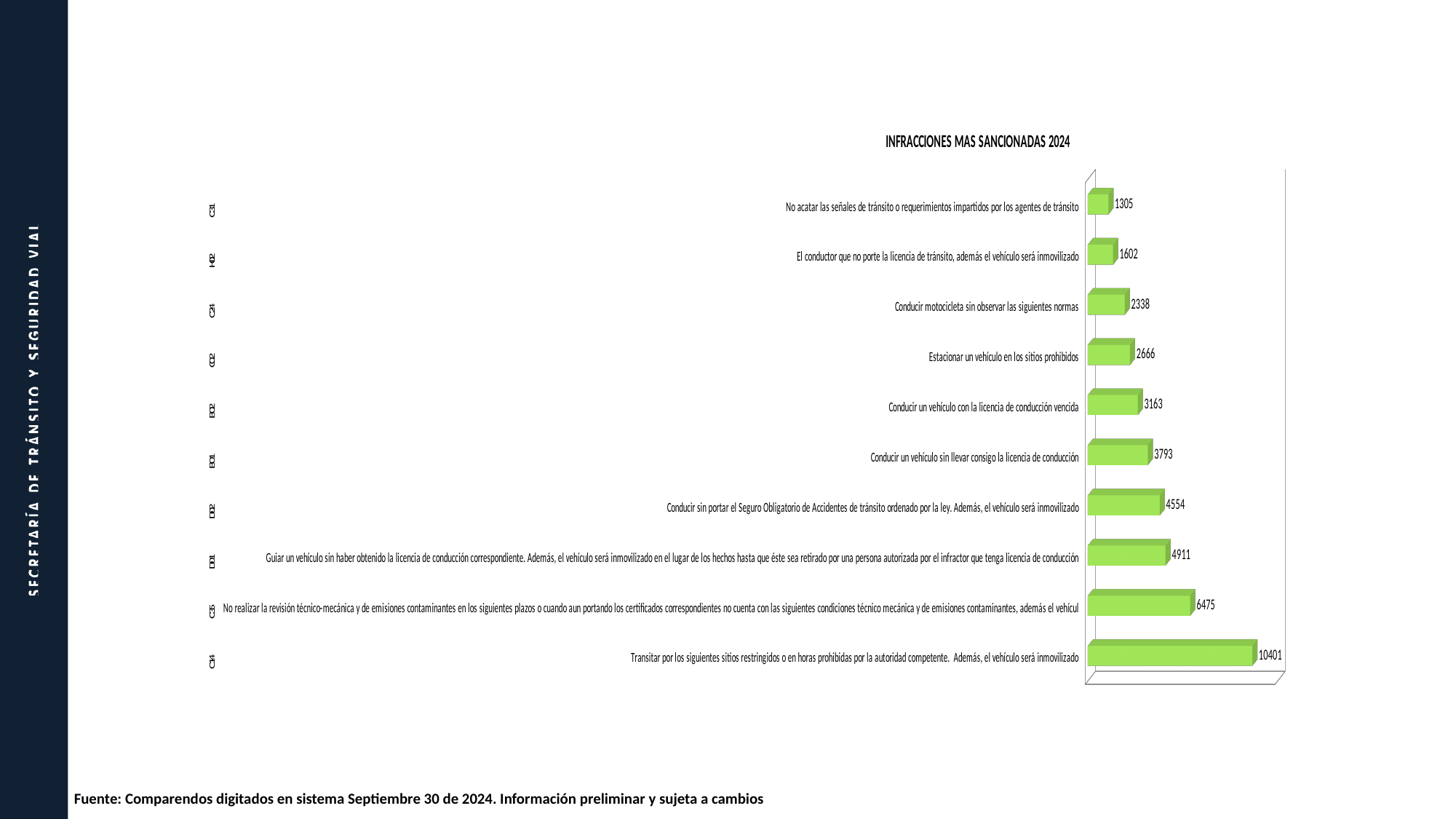
What is the difference between the value for the infraction about transiting restricted sites or prohibited hours (10401) and the value for not performing the technical-mechanical review (6475)? 3926 What is the value for "Conducir motocicleta sin observar las siguientes normas"? 2338 What is the value for "No acatar las señales de tránsito o requerimientos impartidos por los agentes de tránsito"? 1305 What kind of chart is shown on the slide? Bar chart What is the value for "Estacionar un vehículo en los sitios prohibidos"? 2666 What is the value for "Conducir un vehículo sin llevar consigo la licencia de conducción"? 3793 Which infraction has the lowest value in the chart? No acatar las señales de tránsito o requerimientos impartidos por los agentes de tránsito What is the title of the chart? INFRACCIONES MAS SANCIONADAS 2024 How many infraction categories are plotted in the chart? 10 Which is larger: the value for "Conducir un vehículo con la licencia de conducción vencida" or the value for "El conductor que no porte la licencia de tránsito, además el vehículo será inmovilizado"? Conducir un vehículo con la licencia de conducción vencida What is the difference between the value for "Conducir un vehículo sin llevar consigo la licencia de conducción" and the value for "Conducir un vehículo con la licencia de conducción vencida"? 630 Which infraction has the highest value in the chart? Transitar por los siguientes sitios restringidos o en horas prohibidas por la autoridad competente. Además, el vehículo será inmovilizado